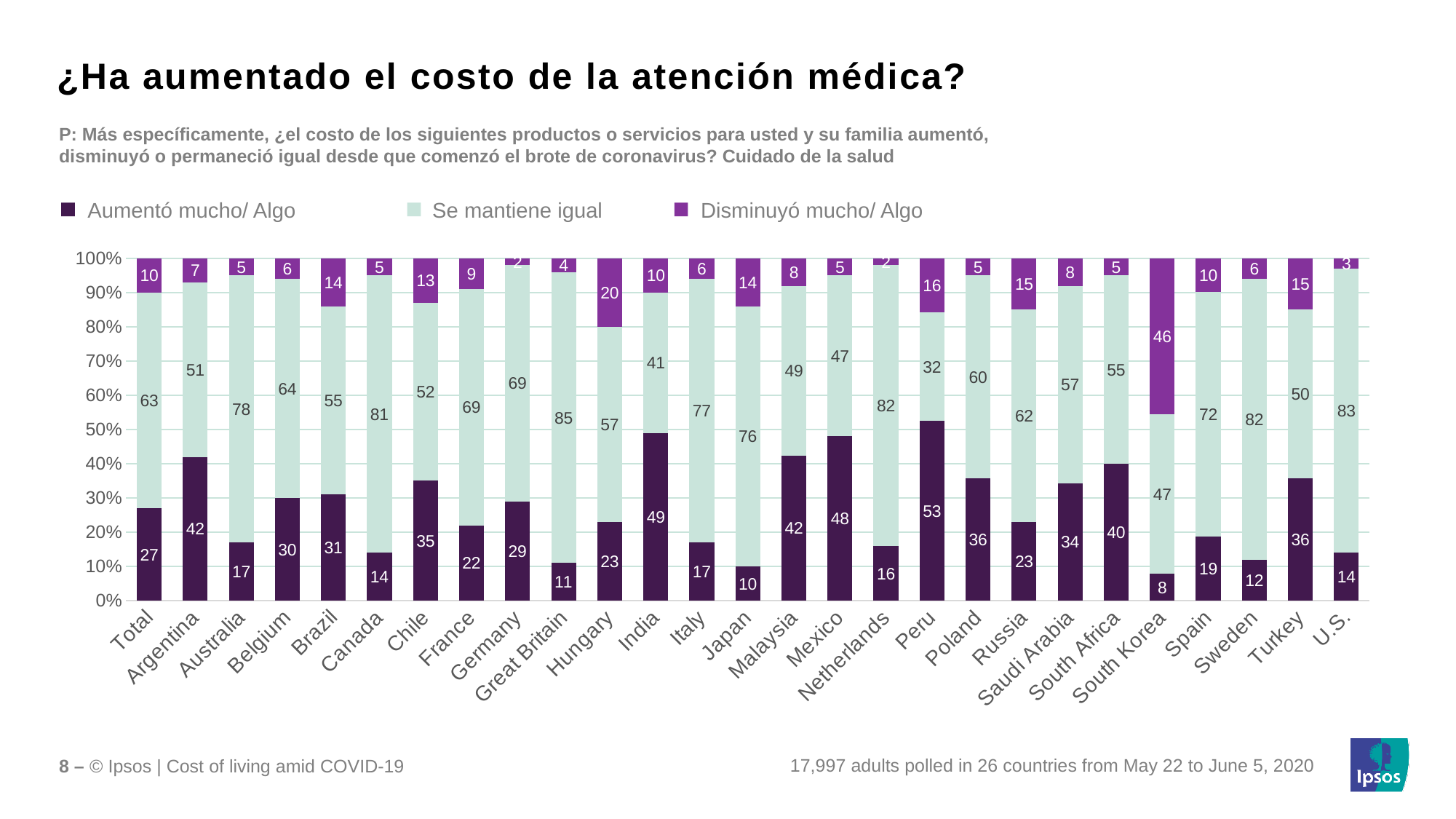
What is the 'Se mantiene igual' value for the Total category? 63 Which country has the highest 'Disminuyó mucho/ Algo' value? South Korea What is the 'Se mantiene igual' value for Great Britain? 85 How many series does the legend list? 3 What is the difference between the 'Aumentó mucho/ Algo' values for India and Italy? 32 What kind of chart is shown on the slide? Stacked bar chart Which is larger, the 'Aumentó mucho/ Algo' value for Argentina or for Brazil? Argentina Which country has the lowest 'Aumentó mucho/ Algo' value? South Korea What percentage of respondents in Peru said the cost of health care 'Aumentó mucho/ Algo'? 53 What is the 'Disminuyó mucho/ Algo' value for South Korea? 46 Which country has the highest 'Aumentó mucho/ Algo' value? Peru How many categories are shown on the x axis? 27